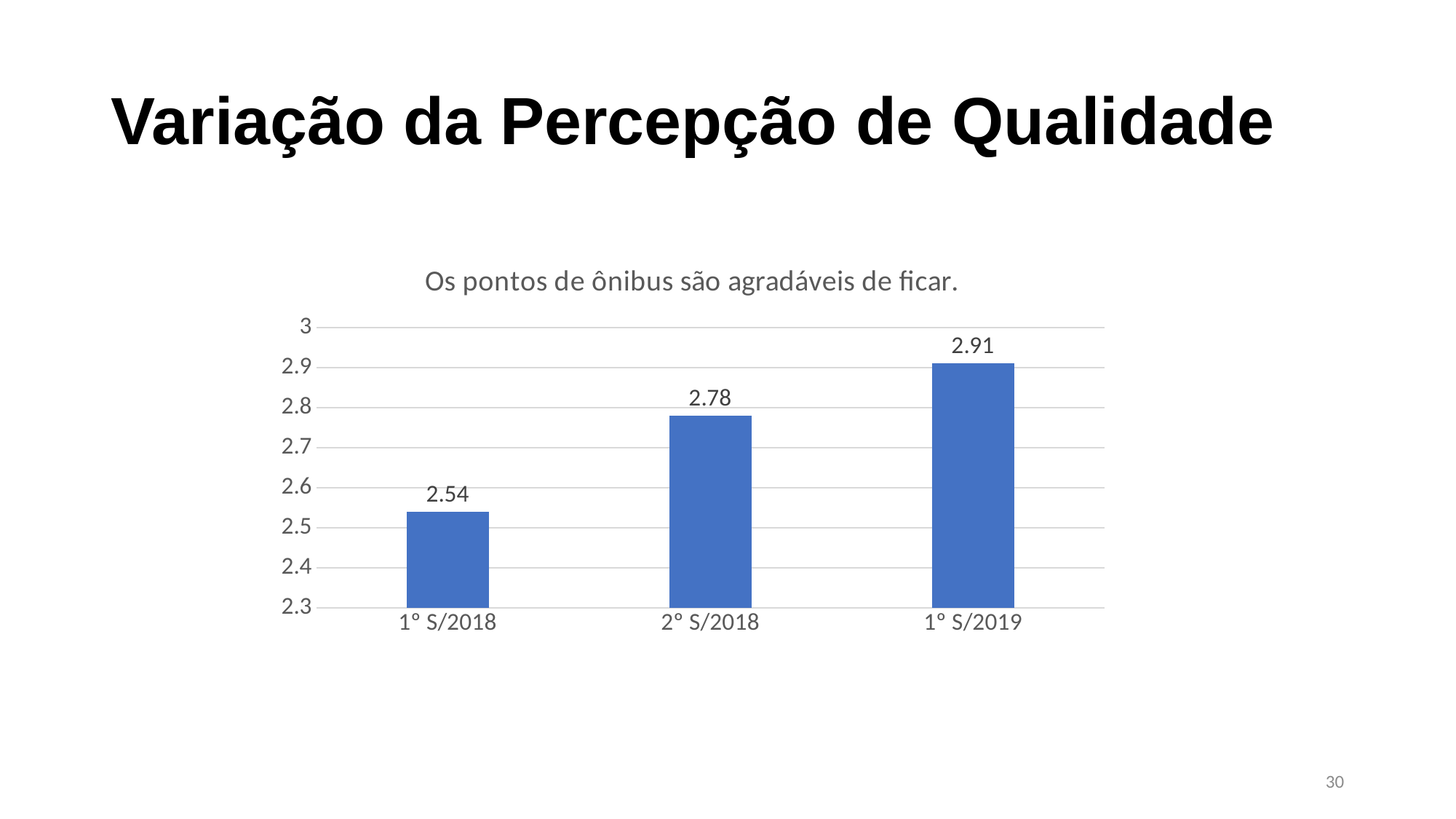
Is the value for 2° S/2018 greater or less than 2.7? greater What is the value for 2° S/2018? 2.78 How many periods are shown on the chart? 3 What is the value for 1° S/2019? 2.91 Which is larger, the value for 2° S/2018 or the value for 1° S/2019? 1° S/2019 What is the difference between the values for 1° S/2019 and 1° S/2018? 0.37 What kind of chart is shown on the slide? bar chart Which period has the lowest value? 1° S/2018 Do the values rise or fall from 1° S/2018 to 1° S/2019? rise Which period has the highest value? 1° S/2019 What is the difference between the values for 2° S/2018 and 1° S/2018? 0.24 What is the value for 1° S/2018? 2.54